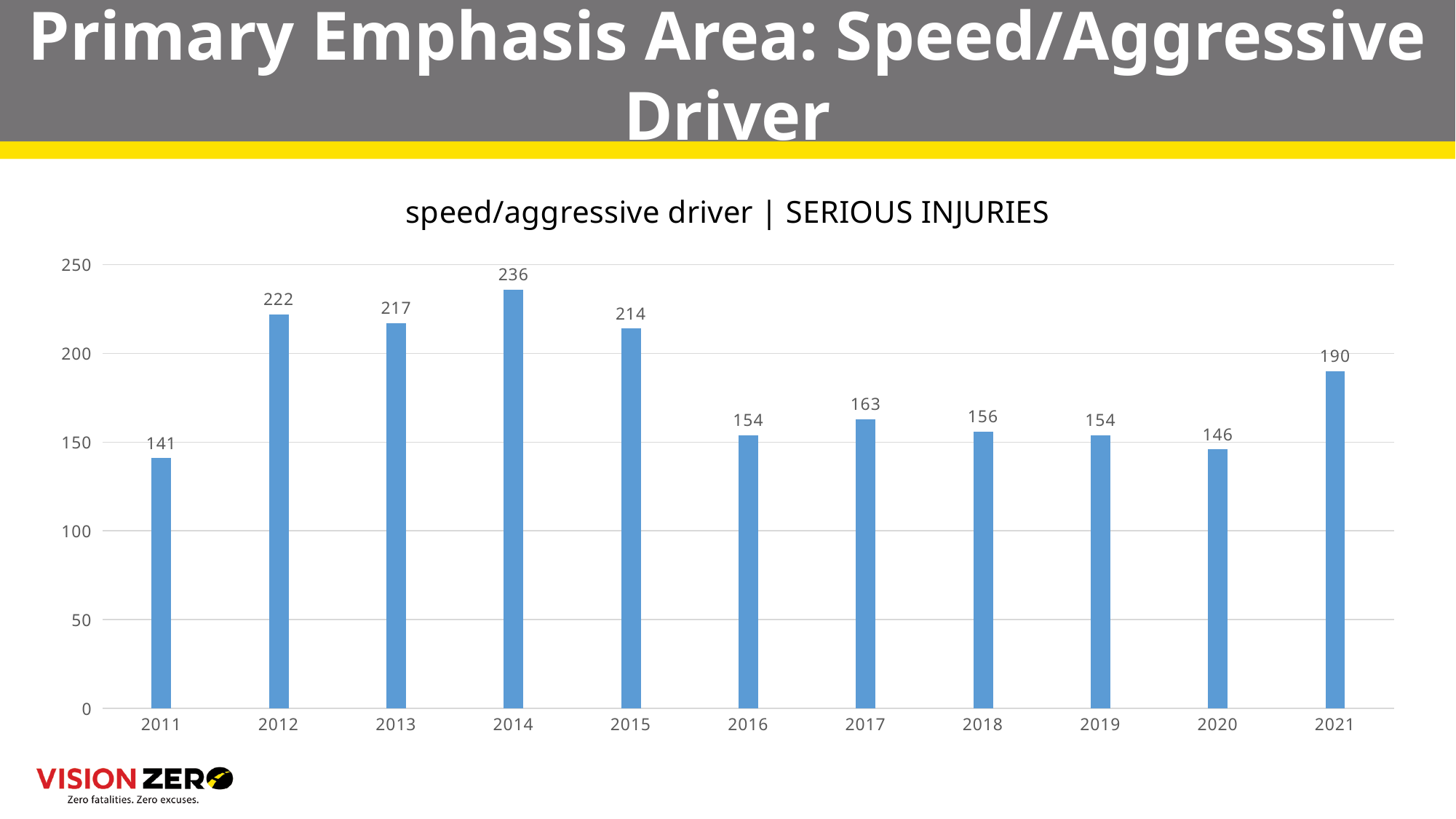
What is the difference between the values for 2021 and 2020? 44 What is the value for 2021? 190 Which year has the lowest value? 2011 What kind of chart is shown on the slide? Bar chart What is the title of the chart? speed/aggressive driver | SERIOUS INJURIES Is the value for 2017 greater or less than 150? greater How many years are shown on the x axis? 11 What is the value for 2011? 141 Which year has the highest value? 2014 What is the value for 2014? 236 Which is larger, the value for 2012 or the value for 2013? 2012 What is the difference between the values for 2014 and 2011? 95